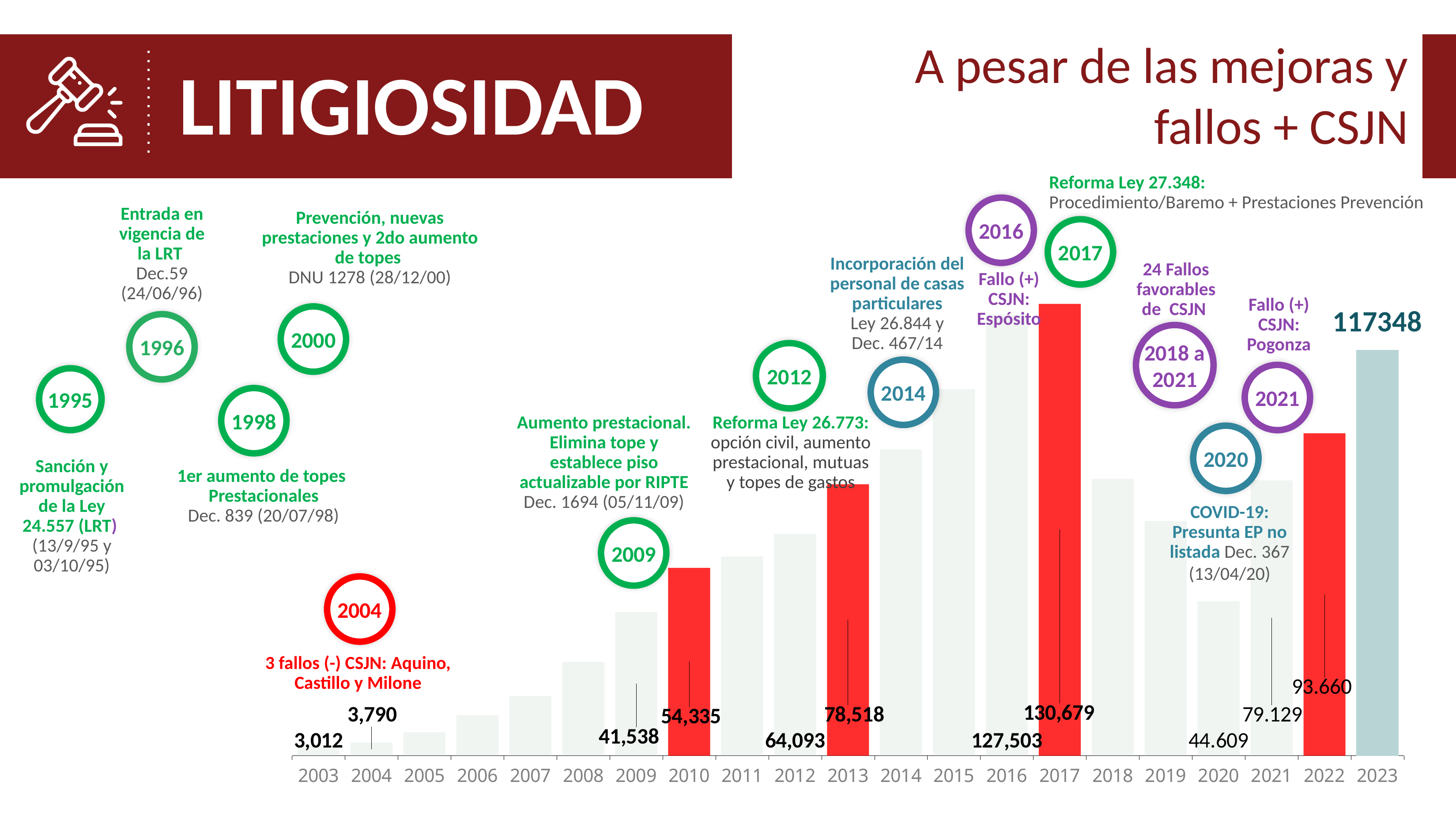
Which year has the lowest bar? 2003 What is the value shown for 2020? 44.609 How many years are shown on the x axis? 21 What is the value shown for 2017? 130,679 What is the value shown for 2003? 3,012 What is the difference between the values for 2017 and 2016? 3,176 What is the difference between the values for 2022 and 2021? 14.531 Do the values rise or fall from 2003 to 2017? rise What type of chart is shown on the slide? bar chart Which year has the highest bar? 2017 Which is larger, the value for 2010 or the value for 2009? 2010 What is the value shown for 2023? 117348